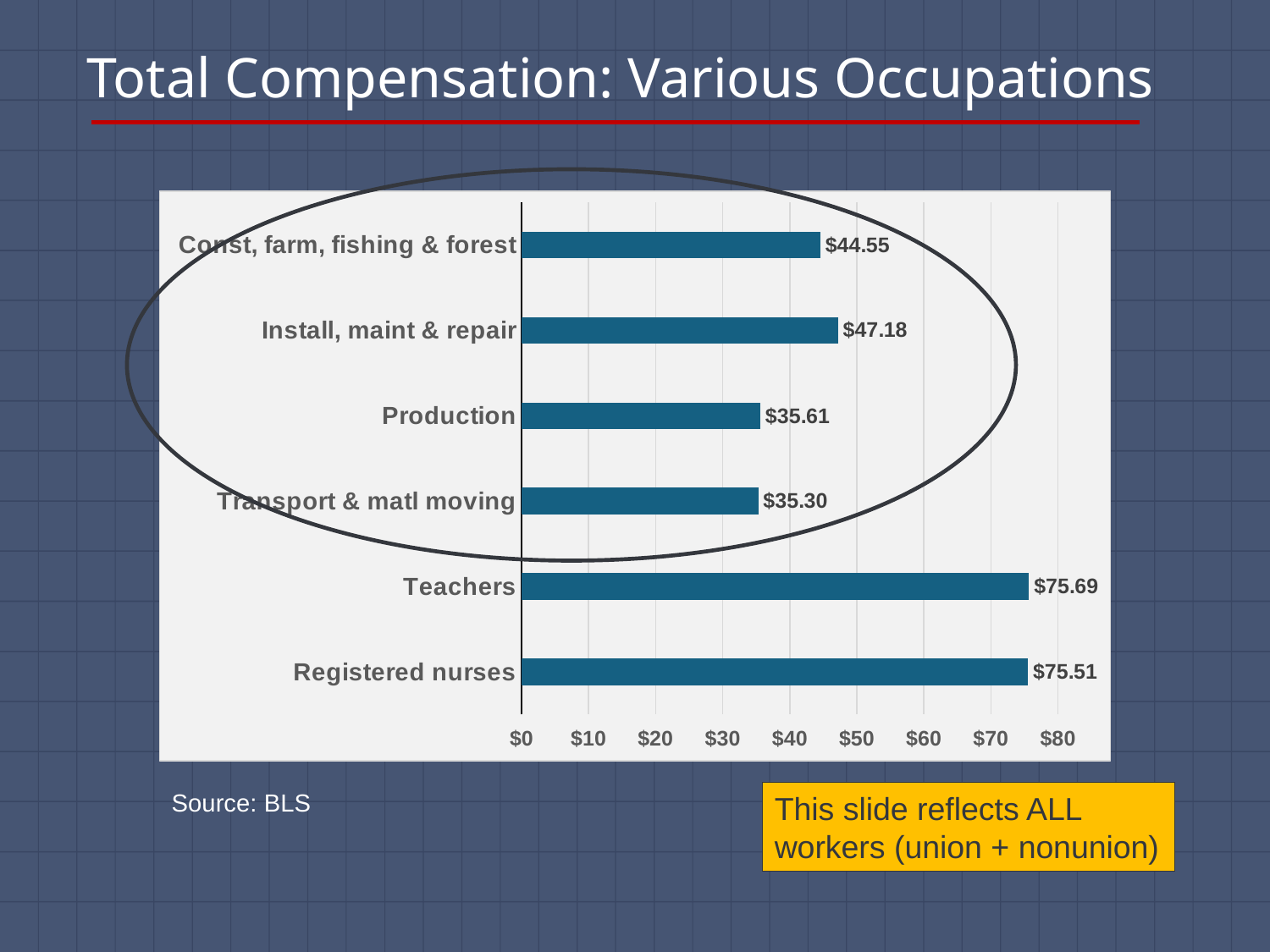
Which occupation has the lowest total compensation? Transport & matl moving What is the difference between the values for Install, maint & repair and Const, farm, fishing & forest? $2.63 What is the value shown for Install, maint & repair? $47.18 What kind of chart is shown on the slide? Bar chart What is the total compensation value for Teachers? $75.69 What is the difference between the values for Teachers and Registered nurses? $0.18 What is the title of the slide? Total Compensation: Various Occupations Is the value for Const, farm, fishing & forest greater or less than $40? greater What is the total compensation value for Production? $35.61 Which is larger, the value for Production or the value for Transport & matl moving? Production How many occupations are shown in the chart? 6 Which occupation has the highest total compensation? Teachers